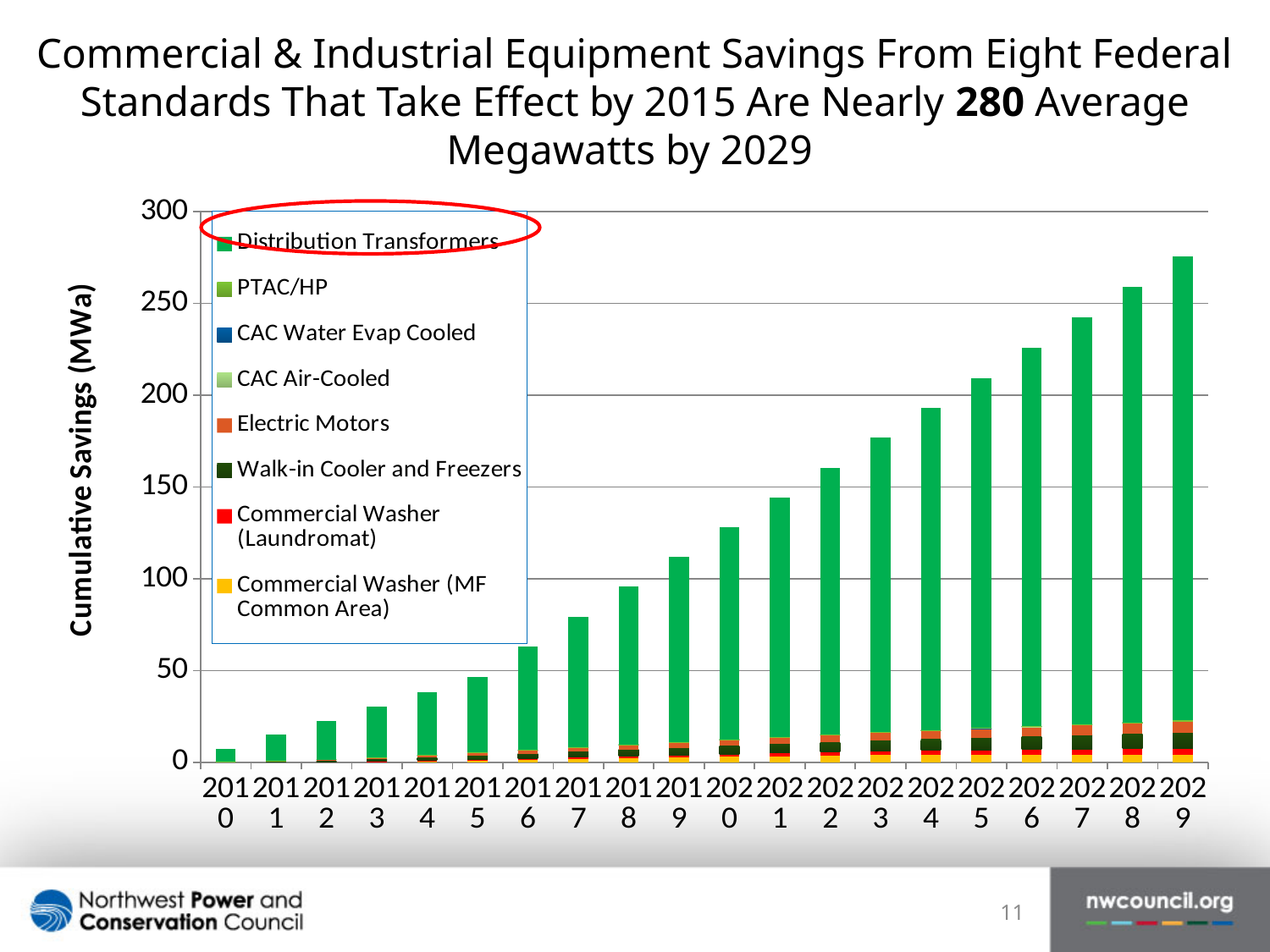
Is the total value for 2014 greater or less than 50? less Do the cumulative savings rise or fall from 2010 to 2029? Rise What kind of chart is shown on the slide? Stacked bar chart How many series does the legend list? 8 How many years are shown along the x axis? 20 Which year has the highest total cumulative savings? 2029 Is the total value for 2023 greater or less than 150? greater Which year has the lowest total cumulative savings? 2010 Is the total value for 2026 greater or less than 200? greater Which year has a larger total, 2020 or 2029? 2029 What is the label on the y axis? Cumulative Savings (MWa)